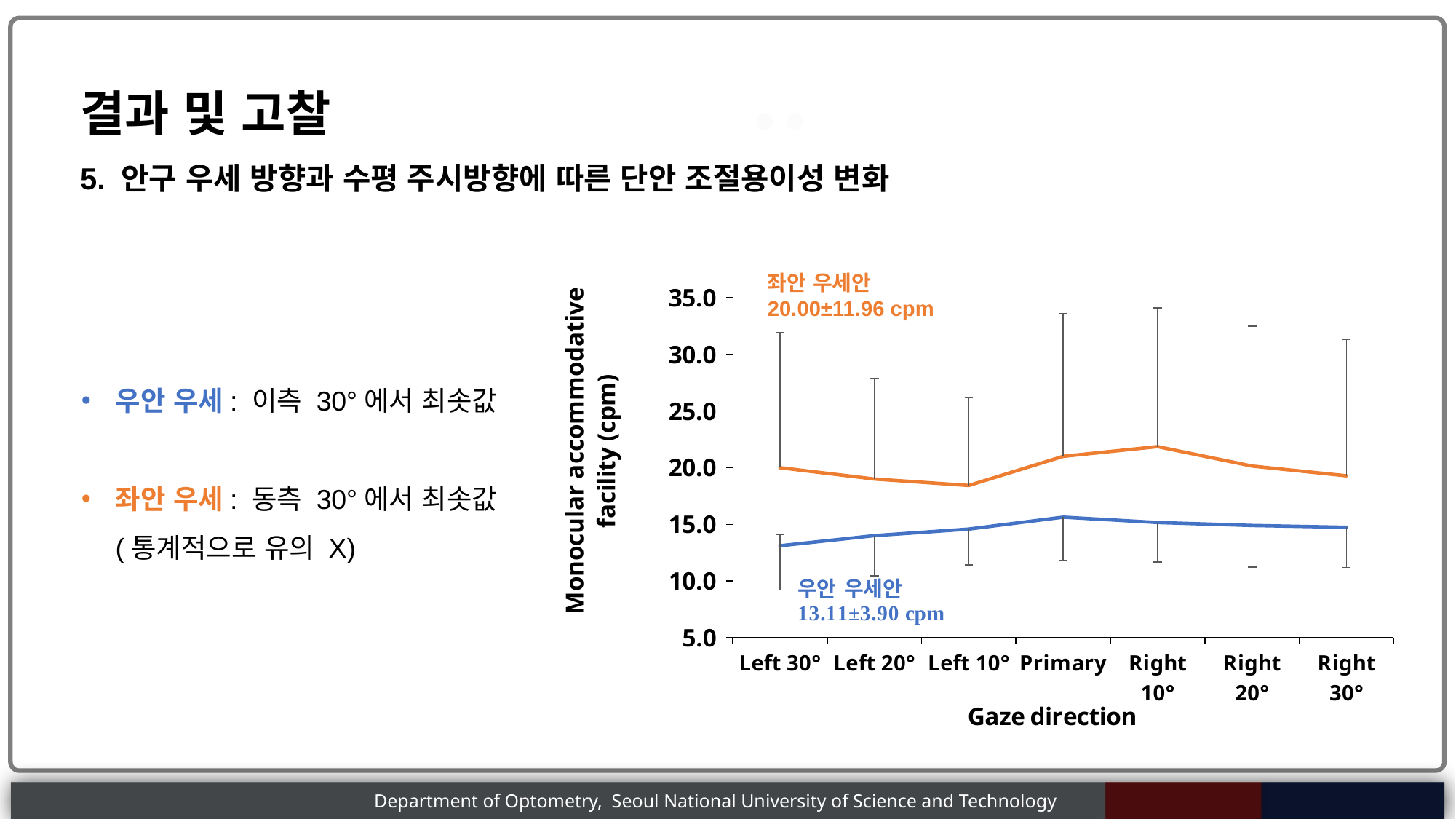
How many gaze direction categories are plotted on the x axis? 7 Does the 우안 우세안 (blue) line rise or fall from Left 30° to Primary? rise What kind of chart is shown on the slide? line chart What value is labelled for the 우안 우세안 series at Left 30°? 13.11±3.90 cpm What value is labelled for the 좌안 우세안 series at Left 30°? 20.00±11.96 cpm At which gaze direction does the 우안 우세안 (blue) line have its lowest value? Left 30° At which gaze direction does the 좌안 우세안 (orange) line reach its lowest value? Left 10° How many data series (lines) are plotted in the chart? 2 At Primary gaze, which series has the larger value, 좌안 우세안 or 우안 우세안? 좌안 우세안 At which gaze direction does the 좌안 우세안 (orange) line reach its highest value? Right 10° What is the title of the x axis of the chart? Gaze direction Is the value of the 좌안 우세안 line at Right 10° greater or less than 20.0? greater